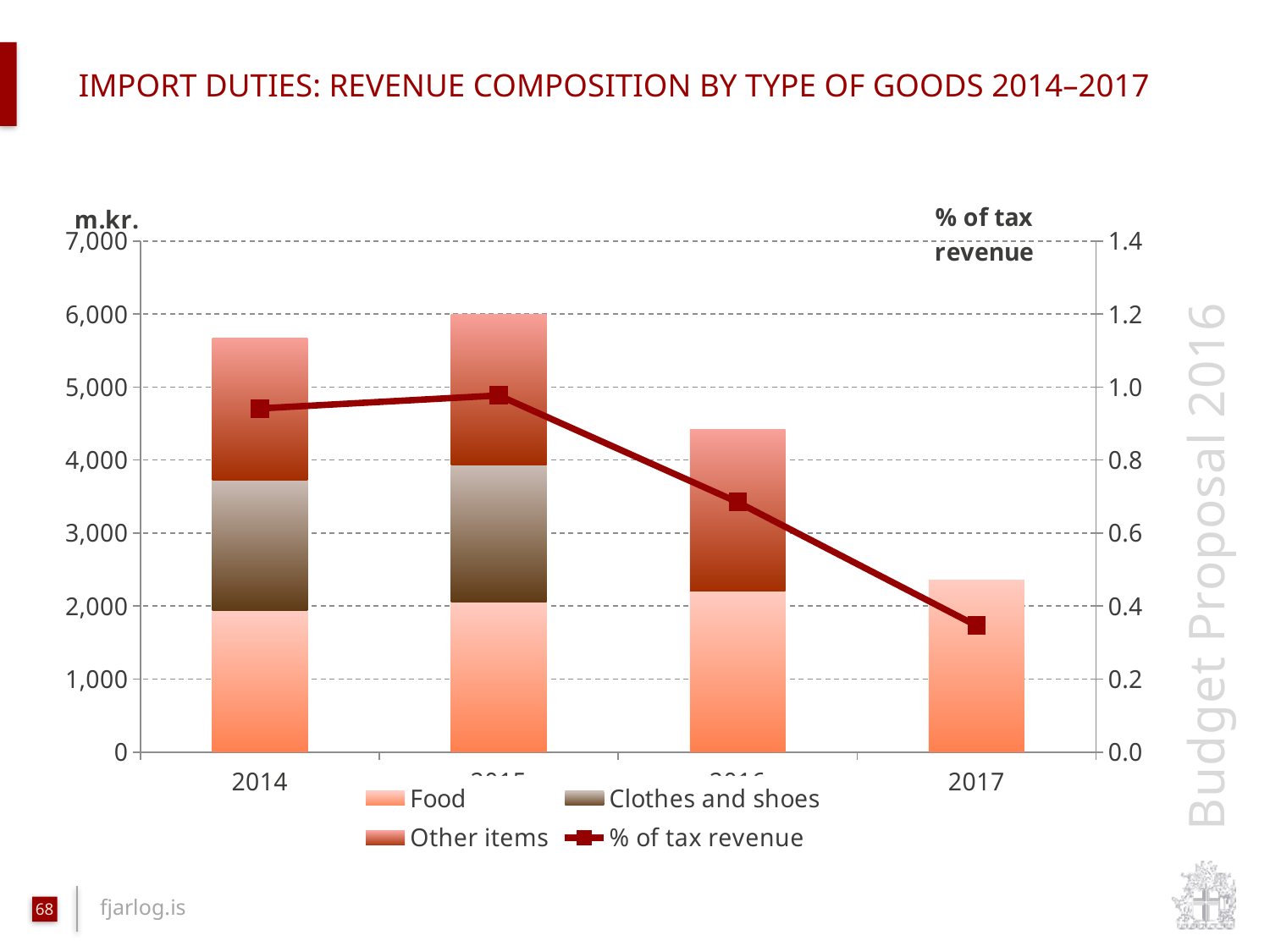
Is the total stacked bar for 2014 greater or less than 5,000 m.kr.? greater Is the total stacked bar for 2017 greater or less than 2,000 m.kr.? greater How many years are shown on the x axis of the chart? 4 Which year has the shortest stacked bar (lowest total import duty revenue)? 2017 Does the % of tax revenue line rise or fall between 2015 and 2017? fall How many series does the chart's legend list? 4 Which year has the tallest stacked bar (highest total import duty revenue)? 2015 What kind of chart is shown on the slide? Stacked bar chart with a line Is the % of tax revenue value for 2016 greater or less than 0.6? greater Which year has a larger total stacked bar, 2014 or 2016? 2014 What is the unit label shown above the left axis of the chart? m.kr.